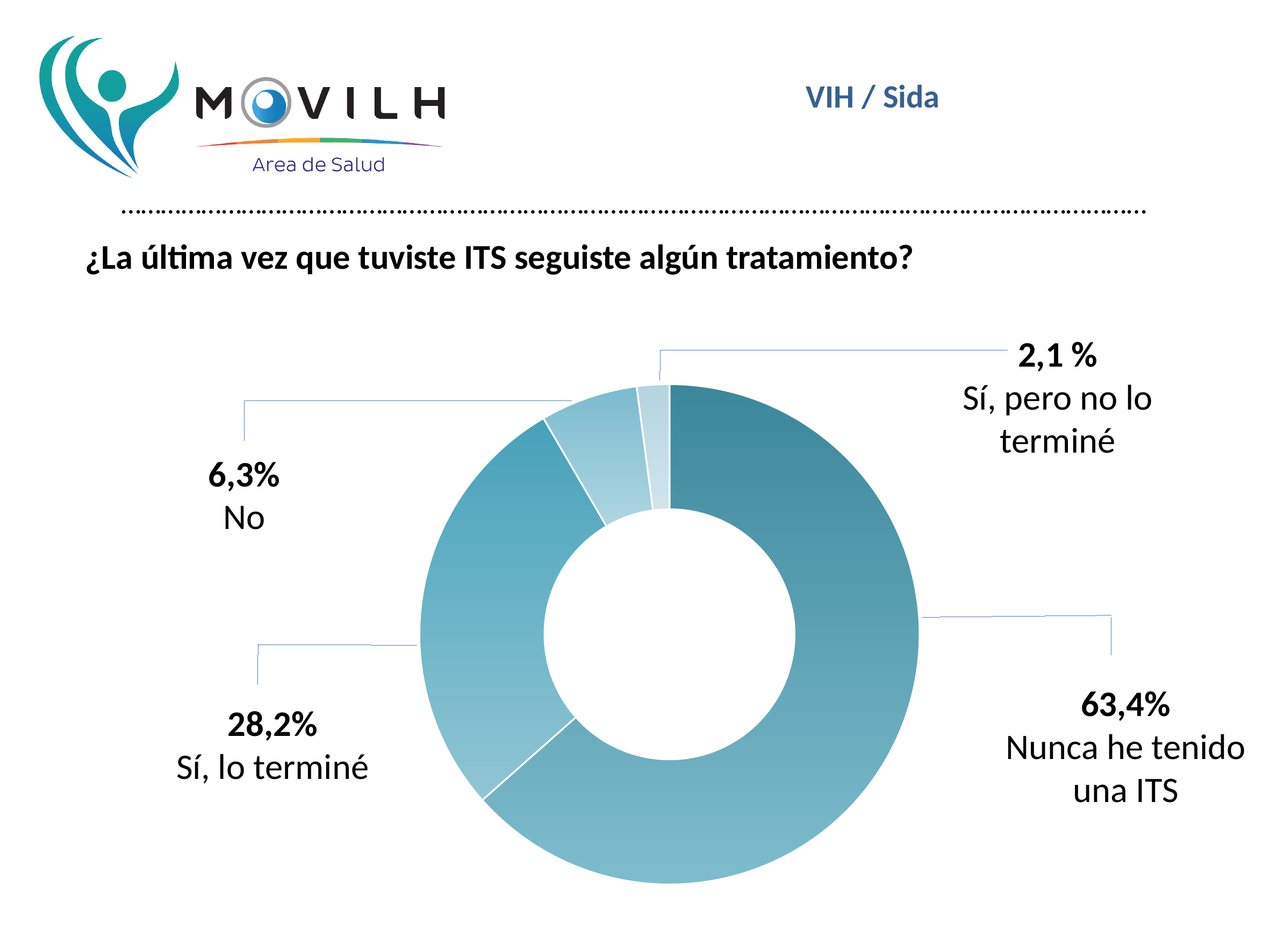
What percentage of respondents answered "Nunca he tenido una ITS"? 63,4% What percentage of respondents answered "Sí, pero no lo terminé"? 2,1 % What is the difference in percentage points between "Nunca he tenido una ITS" and "Sí, lo terminé"? 35,2 What is the difference in percentage points between "Sí, lo terminé" and "No"? 21,9 Which response category has the smallest share of the chart? Sí, pero no lo terminé Which response category has the largest share of the chart? Nunca he tenido una ITS What percentage of respondents answered "Sí, lo terminé"? 28,2% What question does the chart on the slide answer? ¿La última vez que tuviste ITS seguiste algún tratamiento? Which is larger: the share for "No" or the share for "Sí, pero no lo terminé"? No What percentage of respondents answered "No"? 6,3% What kind of chart is shown on the slide? Doughnut (pie) chart How many response categories are shown in the chart? 4